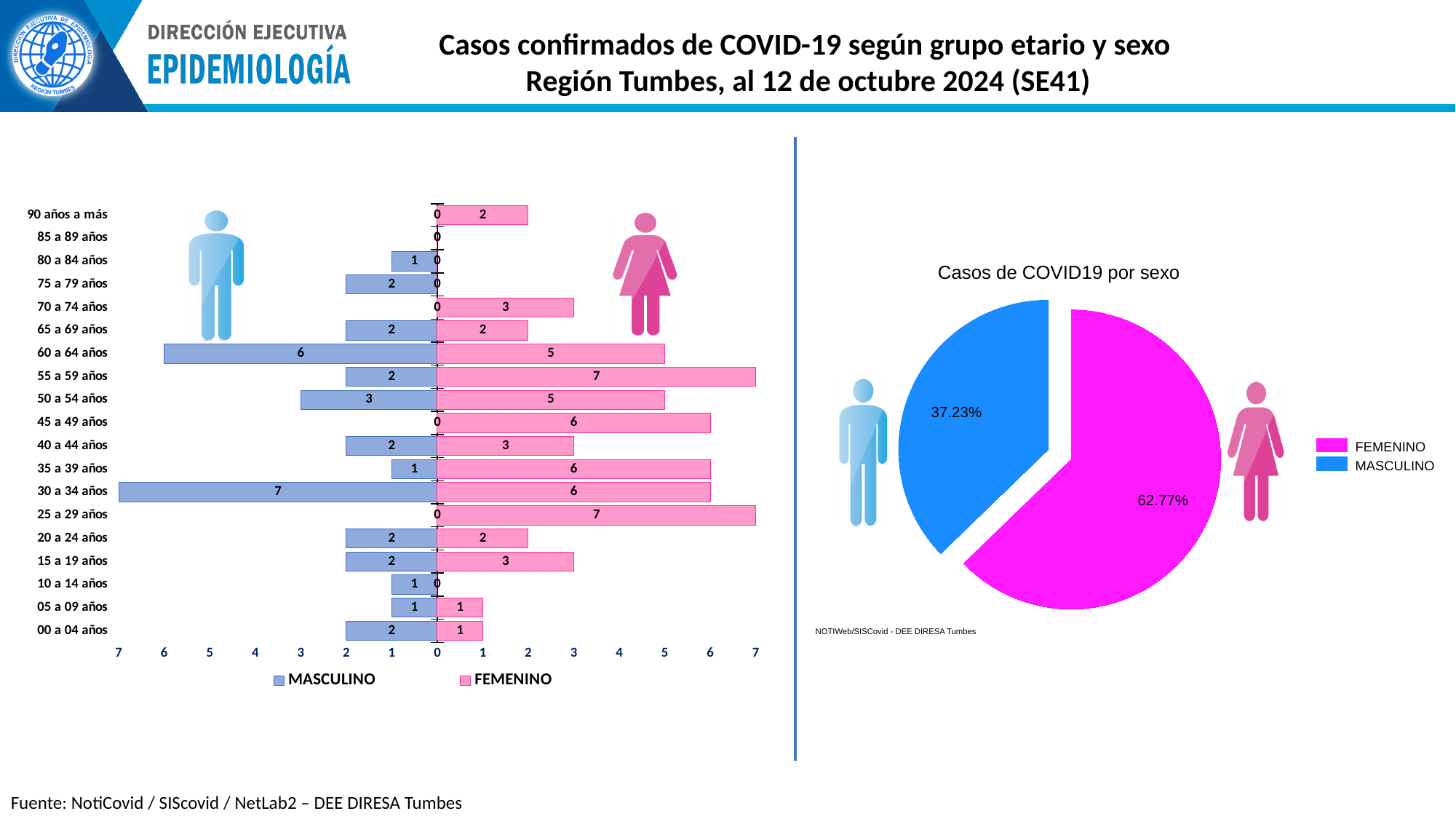
In the left bar chart, which is larger for the 50 a 54 años age group, the MASCULINO value or the FEMENINO value? FEMENINO In the left bar chart, what is the FEMENINO value for the 55 a 59 años age group? 7 In the left bar chart, what is the MASCULINO value for the 60 a 64 años age group? 6 In the left bar chart, which age group has the highest MASCULINO value? 30 a 34 años In the left bar chart, what is the total of MASCULINO and FEMENINO cases for the 30 a 34 años age group? 13 In the pie chart 'Casos de COVID19 por sexo', which colour represents FEMENINO? magenta How many series does the legend of the left chart list? 2 How many age groups are shown in the left bar chart? 19 In the pie chart 'Casos de COVID19 por sexo', what share is MASCULINO? 37.23% What kind of chart is the chart titled 'Casos de COVID19 por sexo'? pie chart In the left bar chart, what is the difference between the FEMENINO and MASCULINO values for the 55 a 59 años age group? 5 In the left bar chart, what is the FEMENINO value for the 25 a 29 años age group? 7